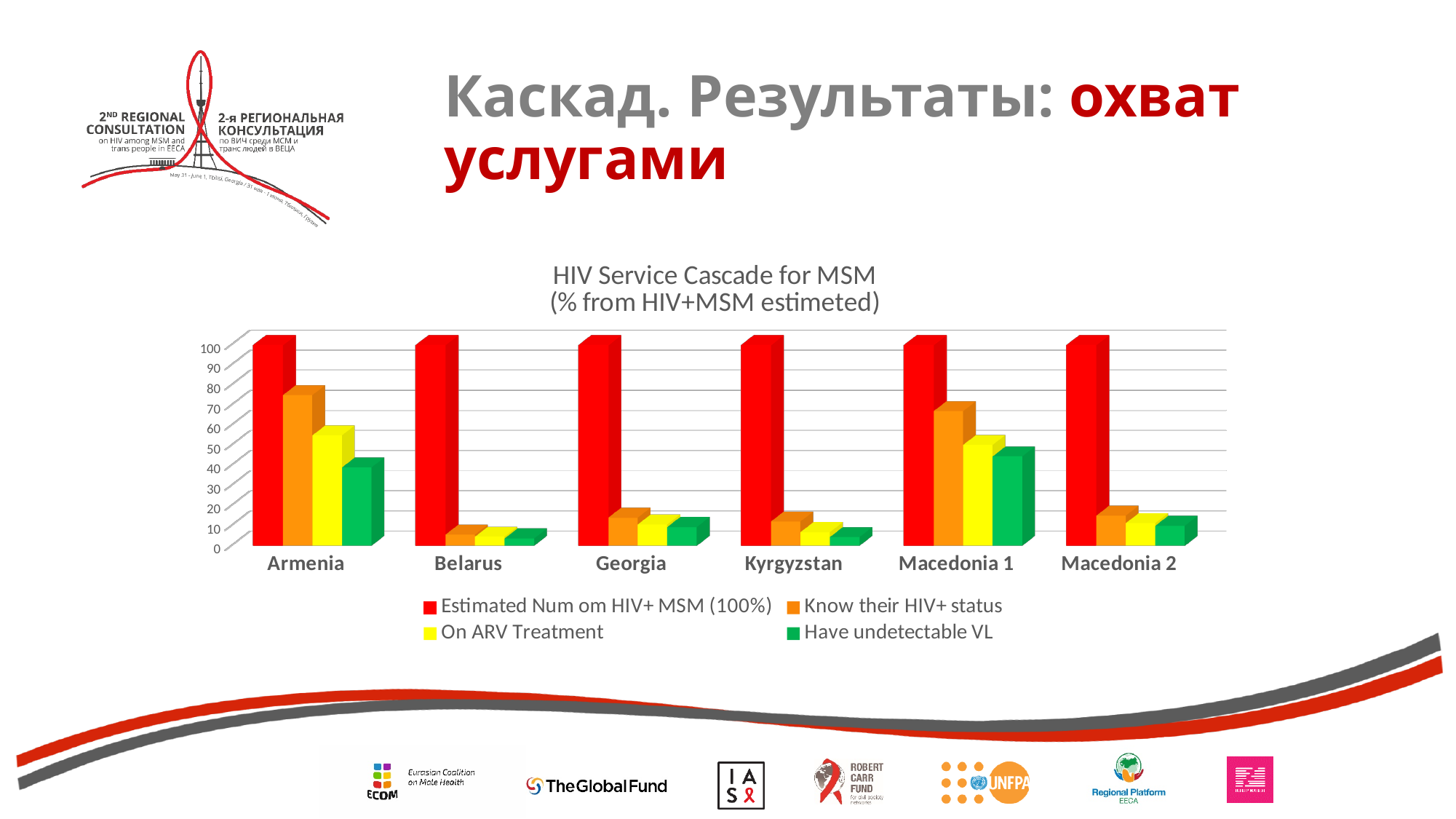
Is the value for 'On ARV Treatment' in Macedonia 1 greater or less than 40? greater What is the value of 'Estimated Num om HIV+ MSM' for Kyrgyzstan? 100 How many countries/categories are shown on the x axis? 6 Which country has the highest value for 'Know their HIV+ status'? Armenia What kind of chart is shown on the slide? bar chart Is the value for 'Know their HIV+ status' in Armenia greater or less than 70? greater How many series does the legend list? 4 What colour represents 'On ARV Treatment' in the chart? yellow Which is larger: 'On ARV Treatment' for Armenia or for Belarus? Armenia Which country has the lowest value for 'Know their HIV+ status'? Belarus Do the bars for Armenia rise or fall going from 'Estimated Num om HIV+ MSM' to 'Have undetectable VL'? fall Is the value for 'Have undetectable VL' in Georgia greater or less than 20? less